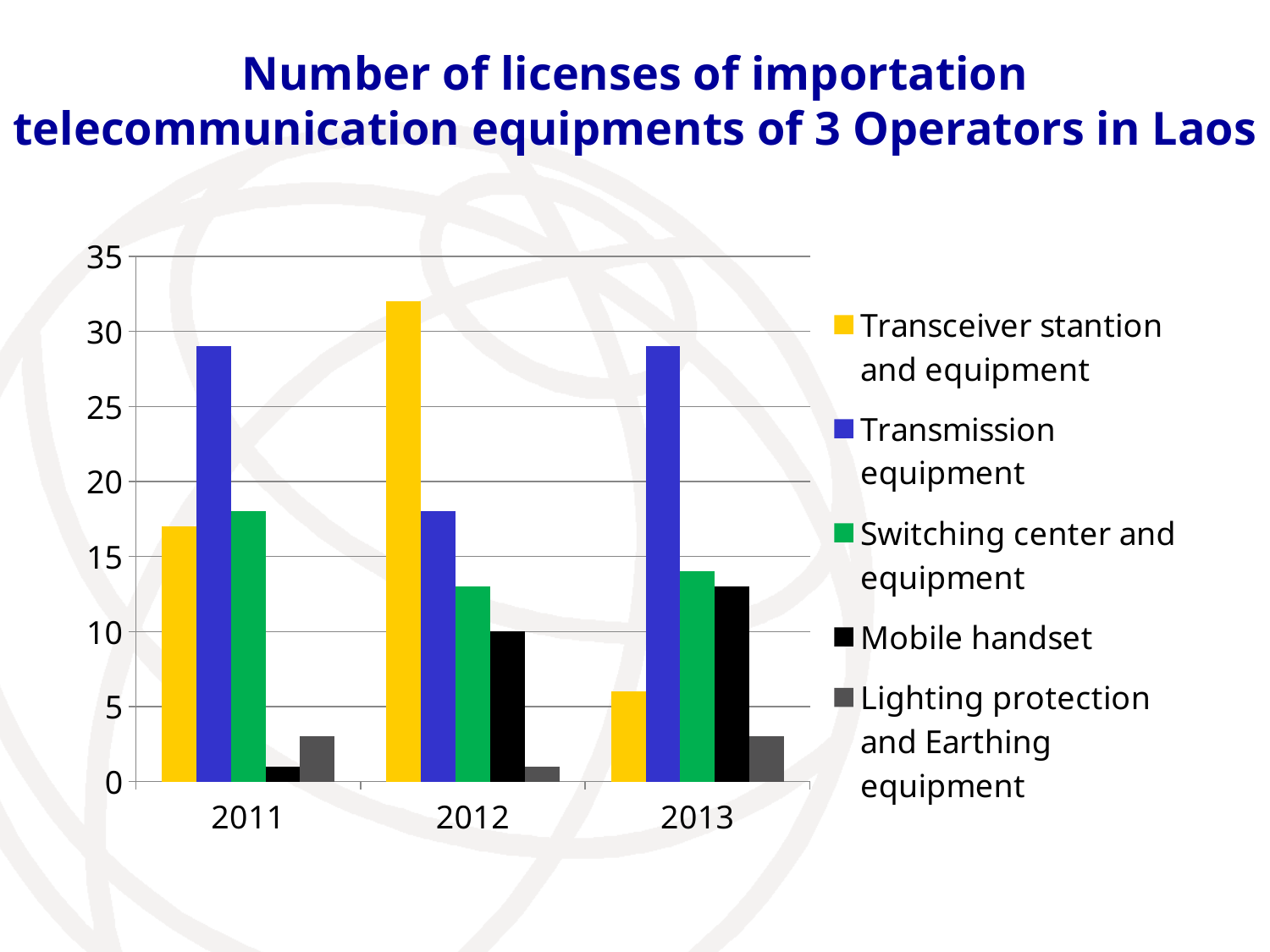
Is the value for Transmission equipment in 2011 greater or less than 25? greater Is the value for Transceiver stantion and equipment in 2013 greater or less than 10? less What colour represents Switching center and equipment in the legend? green How many years are shown on the x axis? 3 Is the value for Transceiver stantion and equipment in 2012 greater or less than 30? greater What kind of chart is shown on the slide? bar chart How many series does the legend list? 5 Which series has the highest value in 2013? Transmission equipment Which is larger in 2012: Transmission equipment or Switching center and equipment? Transmission equipment Which series has the lowest value in 2011? Mobile handset Which series has the highest value in 2012? Transceiver stantion and equipment Does the value for Mobile handset rise or fall from 2011 to 2013? rise